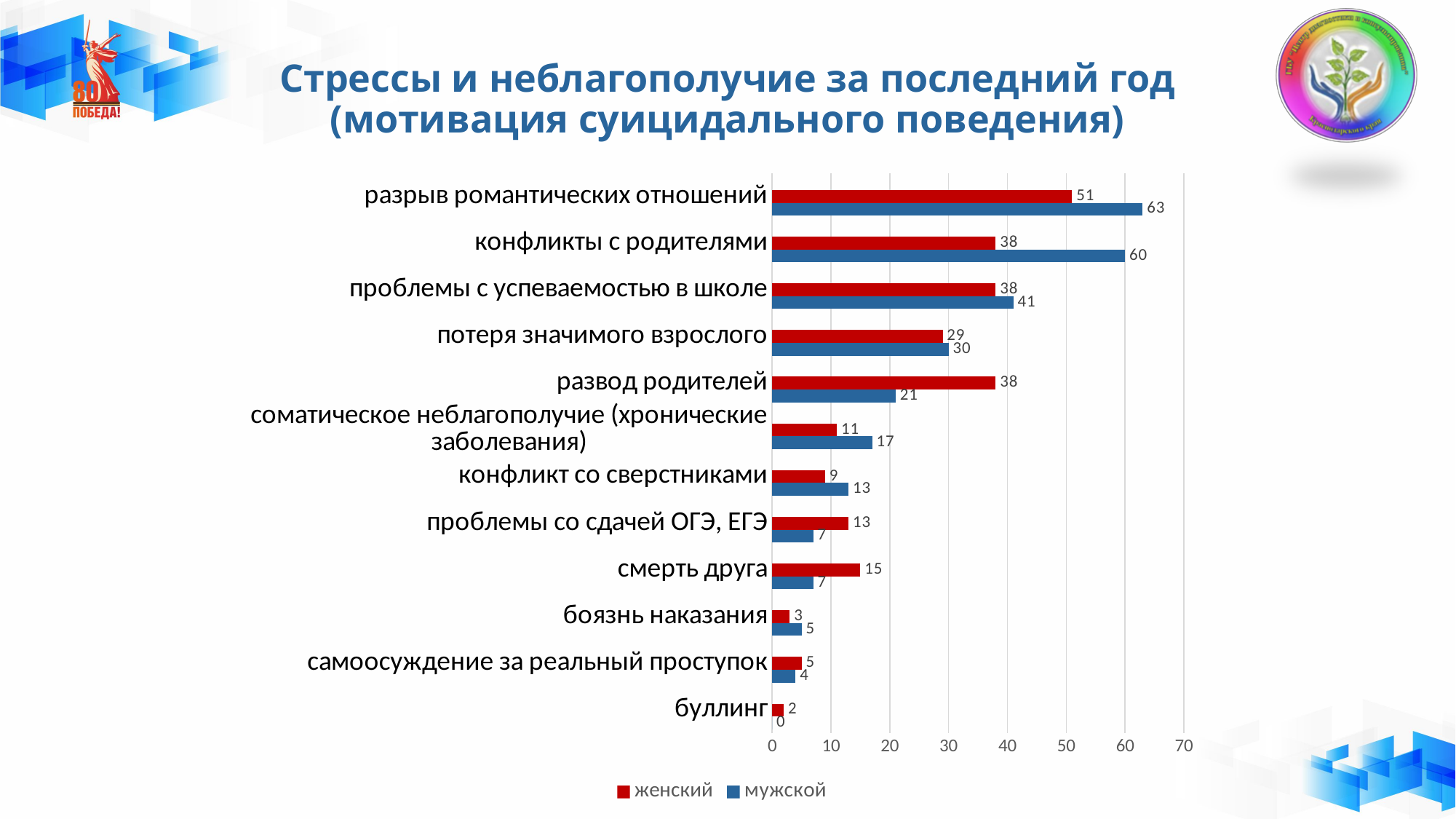
For "смерть друга", which series has the larger value, "женский" or "мужской"? женский Which category has the highest value for "мужской"? разрыв романтических отношений What is the value for "женский" for "проблемы со сдачей ОГЭ, ЕГЭ"? 13 How many series does the legend list? 2 What is the value for "мужской" for "разрыв романтических отношений"? 63 What is the value for "женский" for "развод родителей"? 38 What is the value for "мужской" for "буллинг"? 0 How many categories are shown on the chart? 12 Which colour represents the "мужской" series? blue What is the difference between the "мужской" and "женский" values for "конфликты с родителями"? 22 Which category has the lowest value for "женский"? буллинг What kind of chart is shown on the slide? bar chart